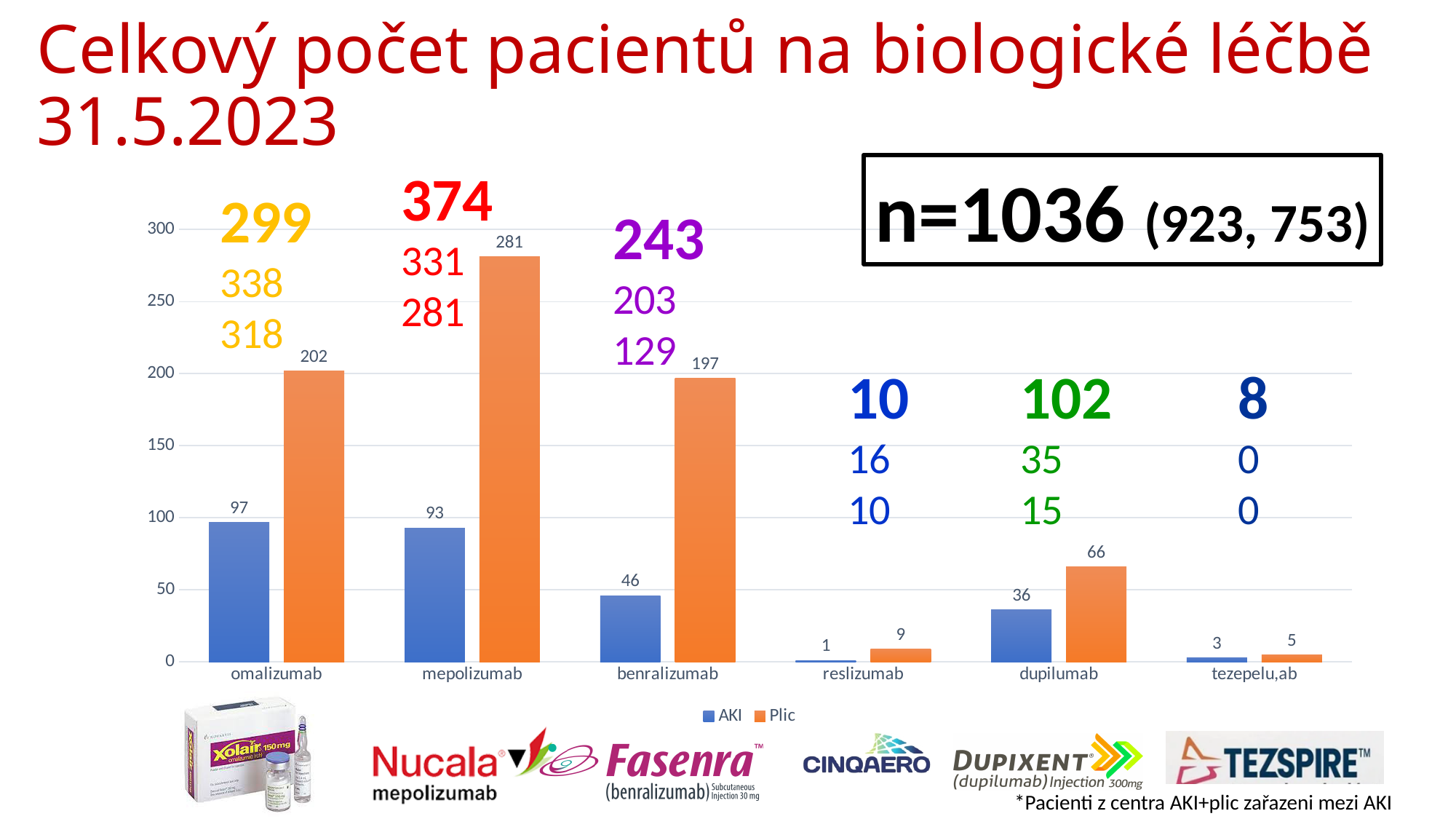
What are the two series named in the legend? AKI and Plic How many series does the legend list? 2 What kind of chart is shown on the slide? bar chart What is the AKI value for omalizumab? 97 What is the Plic value for mepolizumab? 281 What is the difference between the Plic and AKI values for benralizumab? 151 How many categories are shown on the x axis? 6 What is the Plic value for dupilumab? 66 Which is larger, the AKI value for omalizumab or the AKI value for mepolizumab? omalizumab Which category has the highest Plic value? mepolizumab Is the Plic value for omalizumab greater or less than 200? greater Which category has the lowest AKI value? reslizumab